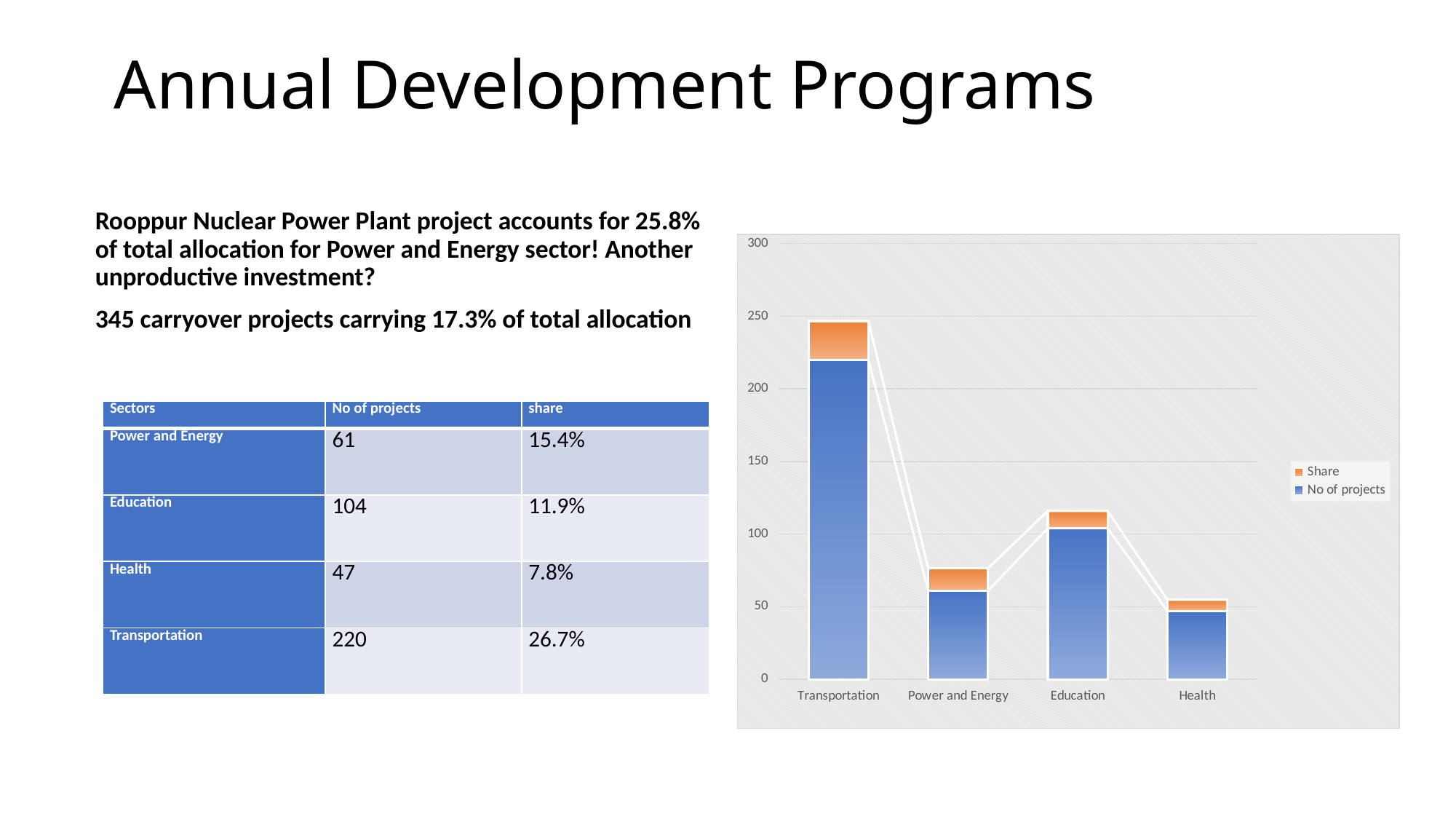
What colour represents the Share series in the chart? Orange Is the No of projects value for Transportation in the chart greater or less than 200? greater Is the total height of the Health bar in the chart greater or less than 100? less Is the No of projects value for Power and Energy in the chart greater or less than 50? greater In the chart, which bar is taller: Education or Power and Energy? Education Which sector has the tallest bar in the chart? Transportation How many sector categories are plotted on the x axis of the chart? 4 What are the two entries listed in the chart legend? Share and No of projects Which sector has the shortest bar in the chart? Health How many series does the chart legend list? 2 What kind of chart is shown on the slide? Stacked bar chart